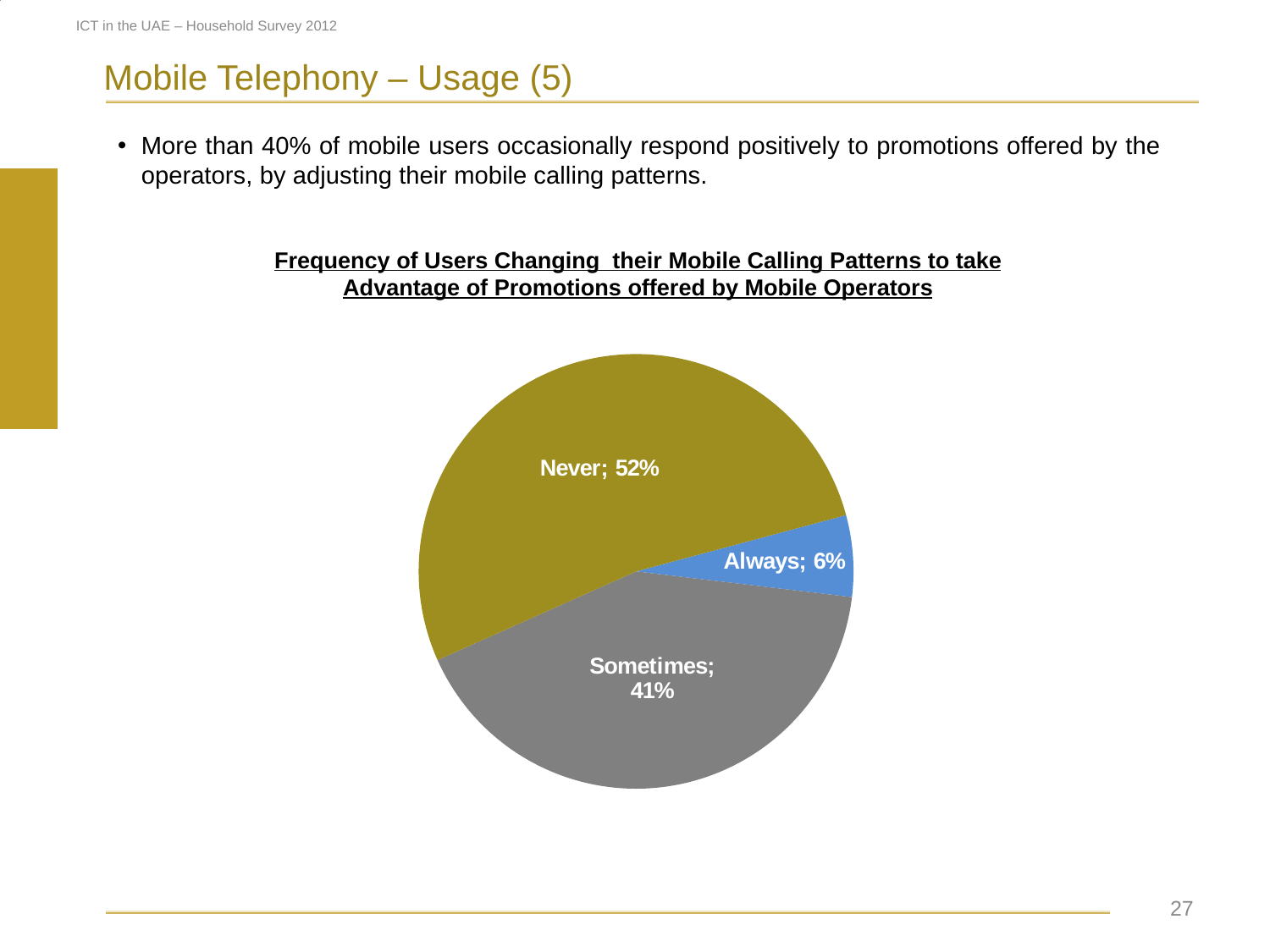
Which category has the smallest slice of the pie? Always What is the difference in percentage points between "Never" and "Sometimes"? 11 Which is larger, the share for "Sometimes" or the share for "Always"? Sometimes Which category has the largest slice of the pie? Never What share of users answered "Always"? 6% What kind of chart is shown on the slide? Pie chart How many categories are shown in the pie chart? 3 What is the title of the chart? Frequency of Users Changing their Mobile Calling Patterns to take Advantage of Promotions offered by Mobile Operators What is the difference in percentage points between "Sometimes" and "Always"? 35 What share of users answered "Never"? 52% What share of users answered "Sometimes"? 41% What colour is the "Always" slice of the pie? Blue